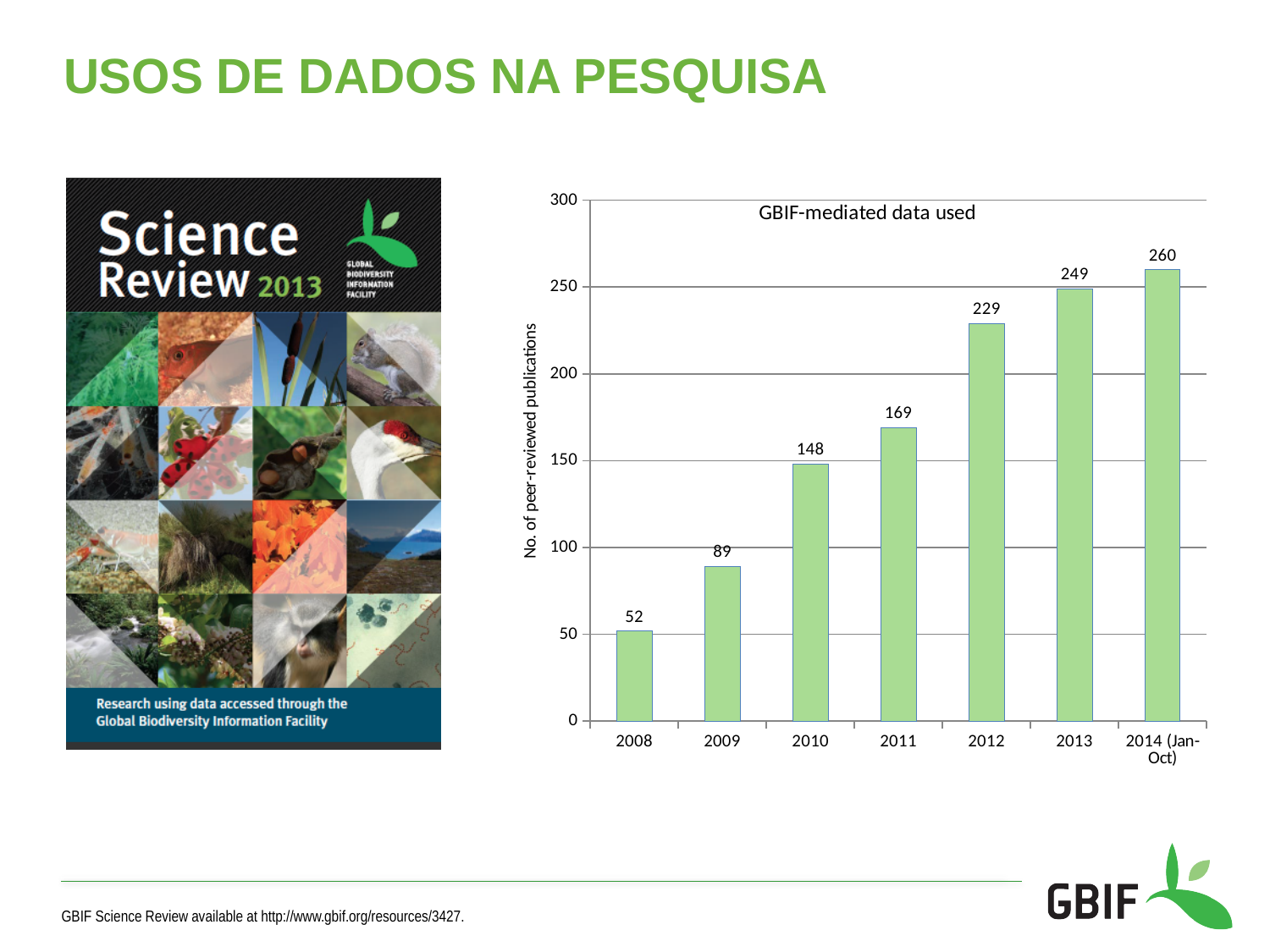
Which is larger, the value for 2009 or the value for 2010? 2010 How many years (categories) are shown on the x axis? 7 Is the value for 2011 greater or less than 150? greater Which year has the lowest number of peer-reviewed publications? 2008 What is the difference between the values for 2012 and 2011? 60 What is the number of peer-reviewed publications for 2013? 249 Which year has the highest number of peer-reviewed publications? 2014 (Jan-Oct) What is the number of peer-reviewed publications for 2010? 148 What kind of chart is shown on the slide? bar chart Do the values rise or fall from 2008 to 2014 (Jan-Oct)? rise What is the title of the chart? GBIF-mediated data used What is the value shown for 2014 (Jan-Oct)? 260